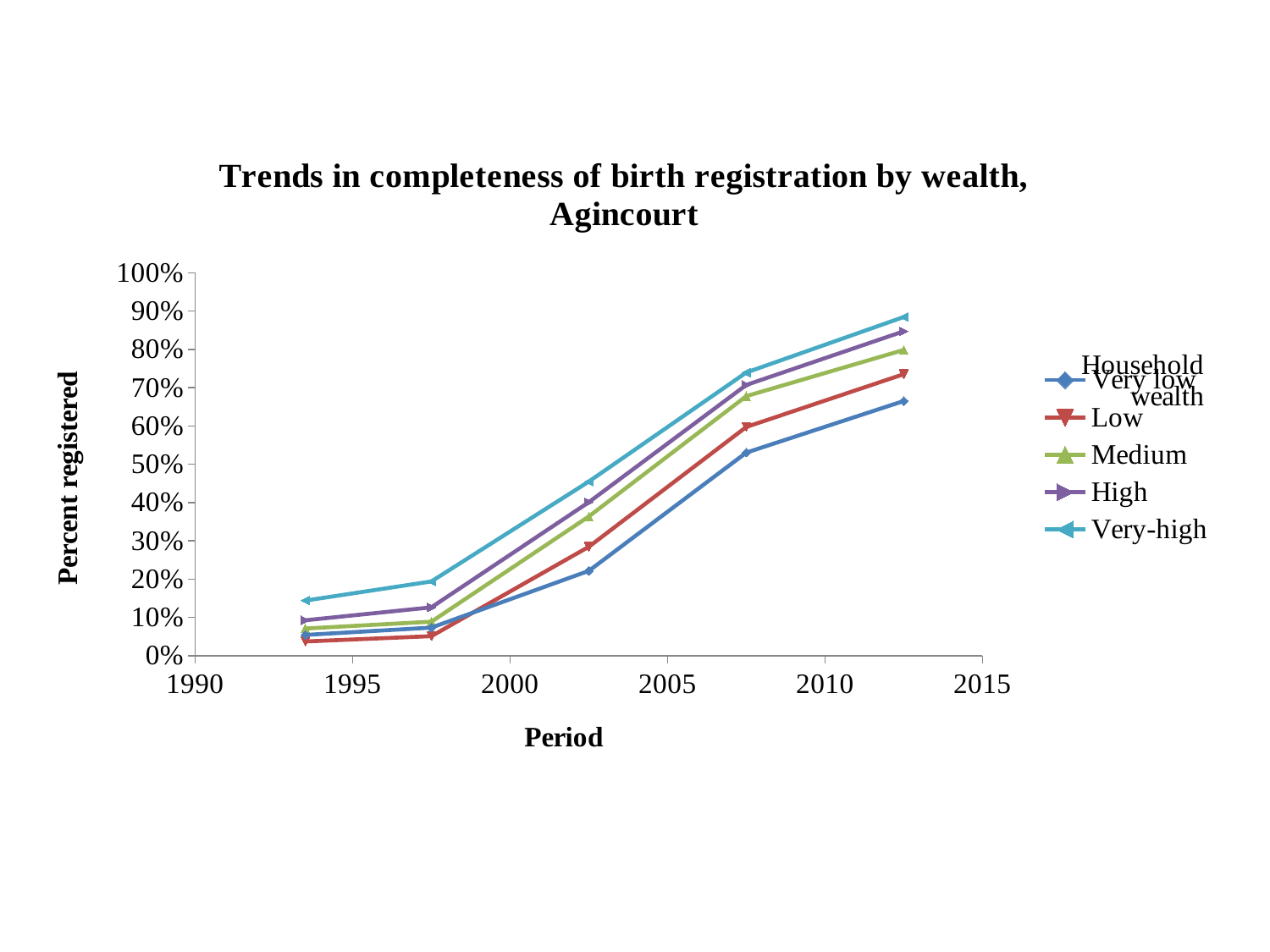
What kind of chart is shown on the slide? line chart What is the label of the vertical axis? Percent registered Is the value for the Very low series at the last time point greater or less than 60%? greater Which series has the highest value at the last time point (around 2012)? Very-high How many series does the legend list? 5 How many data points does each line have? 5 Is the value for the Low series at the first time point (around 1993) greater or less than 10%? less Do the values for the Very-high series rise or fall over time along the x axis? rise Which series has the lowest value at the last time point (around 2012)? Very low At the last time point, which is larger: the value for Very-high or the value for Very low? Very-high Is the value for the Very-high series at the last time point greater or less than 80%? greater What is the title of the chart? Trends in completeness of birth registration by wealth, Agincourt